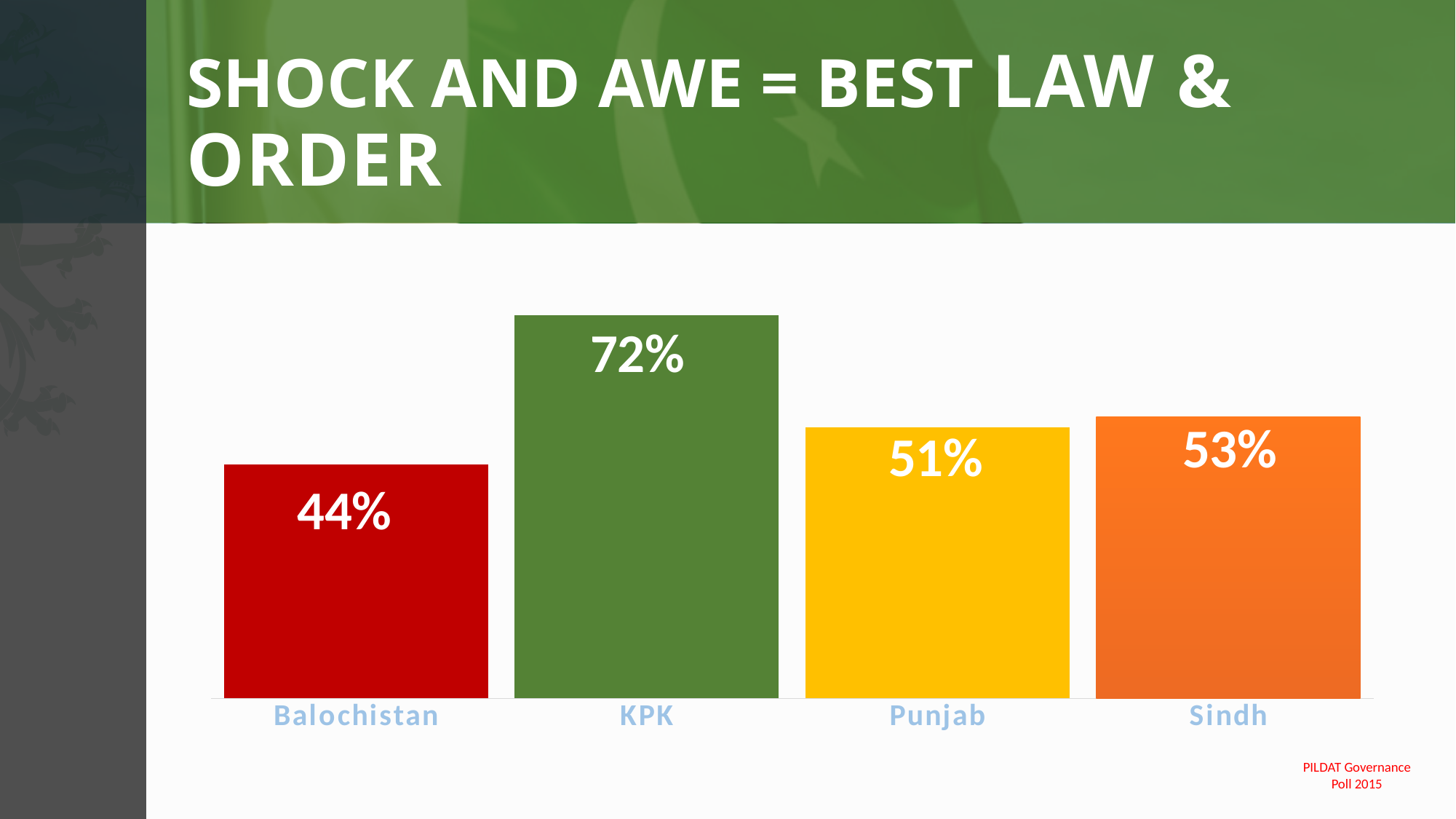
What is the value for Sindh? 53% What is the value for KPK? 72% What colour is the bar for KPK? Green Which province has the highest value? KPK What kind of chart is shown on the slide? Bar chart What is the difference between the values for Sindh and Punjab? 2% Which is larger, the value for Punjab or the value for Balochistan? Punjab What is the value for Punjab? 51% How many provinces are shown in the chart? 4 What is the difference between the values for KPK and Balochistan? 28% What is the value for Balochistan? 44% Which province has the lowest value? Balochistan